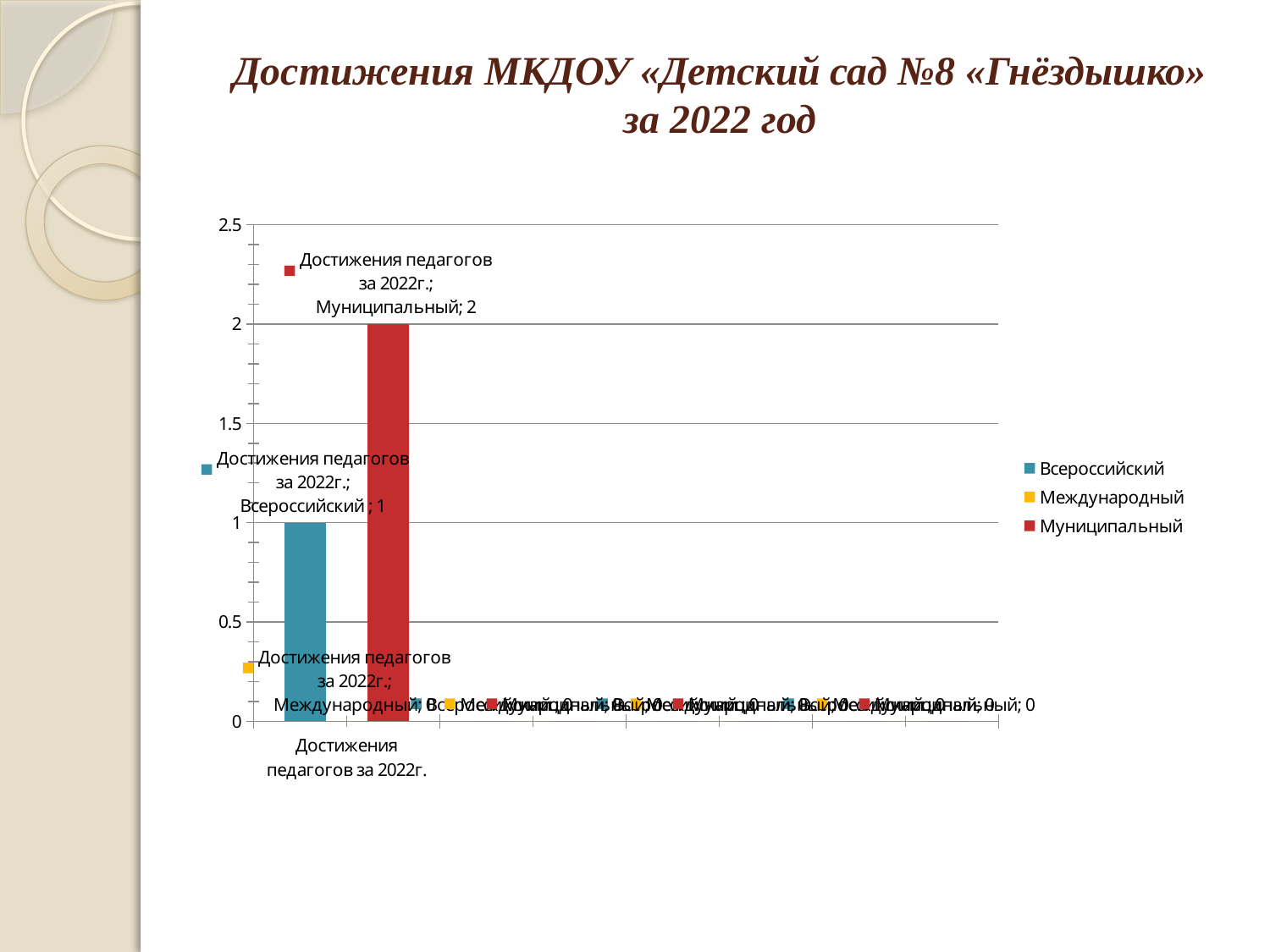
What is the value for Муниципальный in the category Достижения педагогов за 2022г.? 2 How many series does the legend list? 3 Which series has the highest value in the category Достижения педагогов за 2022г.? Муниципальный What kind of chart is shown on the slide? bar chart What is the value for Всероссийский in the category Достижения педагогов за 2022г.? 1 What is the value for Международный in the category Достижения педагогов за 2022г.? 0 Which is larger for Достижения педагогов за 2022г.: the Всероссийский value or the Муниципальный value? Муниципальный Which series is shown in red in the legend? Муниципальный What is the title of the slide containing the chart? Достижения МКДОУ «Детский сад №8 «Гнёздышко» за 2022 год What is the difference between the Муниципальный and Всероссийский values for Достижения педагогов за 2022г.? 1 Is the value for Муниципальный in Достижения педагогов за 2022г. greater or less than 1.5? greater Which series has the lowest value in the category Достижения педагогов за 2022г.? Международный